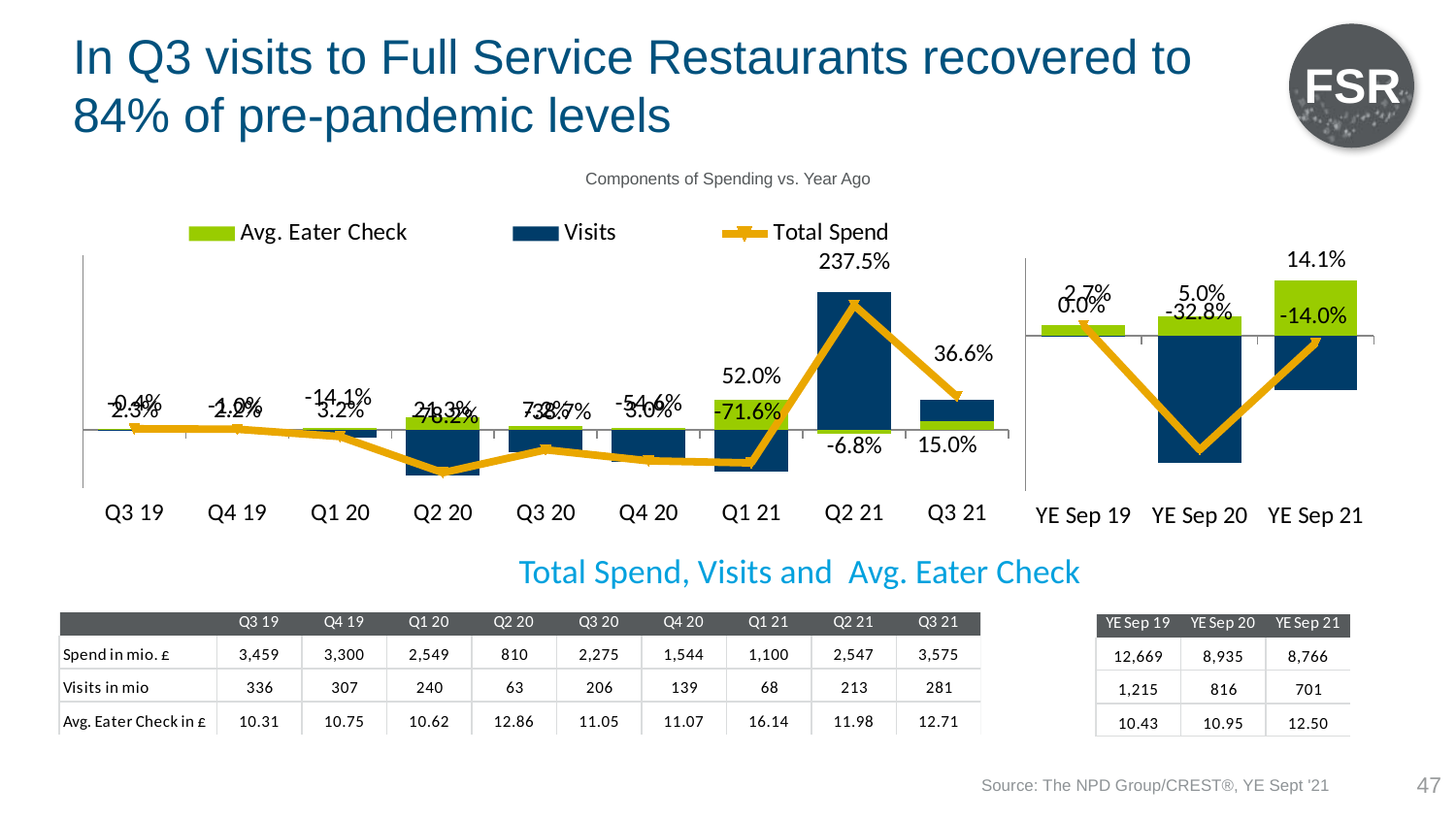
In the quarterly chart on the left, what is the Visits value for Q1 21? -71.6% In the quarterly chart on the left, what is the Avg. Eater Check value for Q2 21? -6.8% In the year-ending chart on the right, what is the Avg. Eater Check value for YE Sep 21? 14.1% In the quarterly chart on the left, what is the difference between the Visits value and the Avg. Eater Check value for Q3 21? 21.6 percentage points In the year-ending chart on the right, what is the Visits value for YE Sep 21? -14.0% How many series does the legend of the quarterly chart list? 3 In the quarterly chart on the left, what is the Avg. Eater Check value for Q3 21? 15.0% In the year-ending chart on the right, what is the Visits value for YE Sep 20? -32.8% In the quarterly chart on the left, what is the Visits value for Q2 21? 237.5% In the quarterly chart on the left, which quarter has the highest Visits value? Q2 21 In the quarterly chart on the left, which is larger, the Visits value for Q2 21 or for Q3 21? Q2 21 In the quarterly chart on the left, what is the Visits value for Q3 21? 36.6%